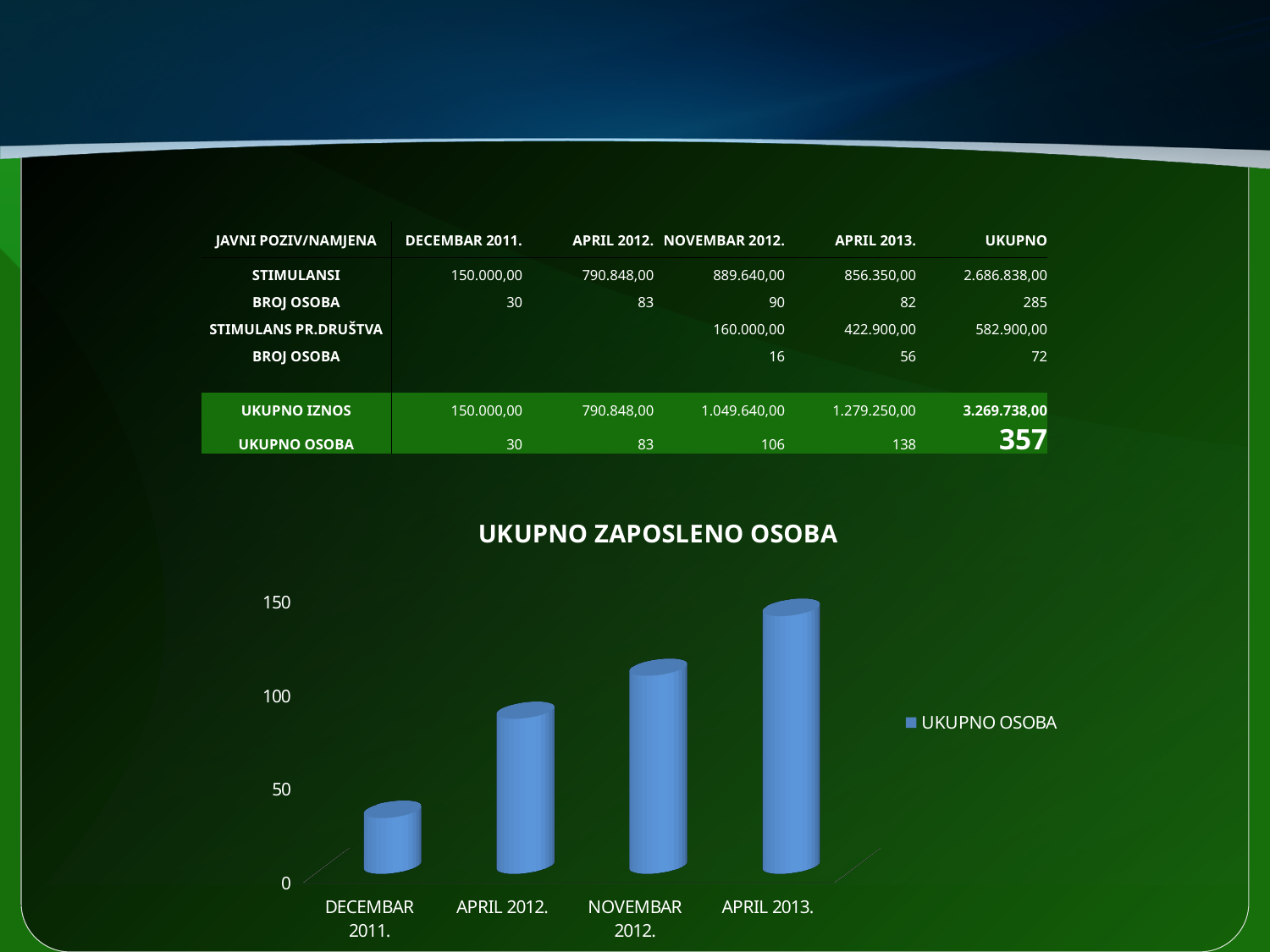
What kind of chart is shown under the title UKUPNO ZAPOSLENO OSOBA? bar chart Which category has the lowest bar in the chart? DECEMBAR 2011. Is the value for DECEMBAR 2011. greater or less than 50? less How many series does the chart legend list? 1 Is the value for APRIL 2012. greater or less than 100? less How many categories are shown on the x axis of the chart? 4 Which category has the highest bar in the chart? APRIL 2013. Do the values in the chart rise or fall from DECEMBAR 2011. to APRIL 2013.? rise What is the name of the series in the chart legend? UKUPNO OSOBA What is the title of the chart? UKUPNO ZAPOSLENO OSOBA